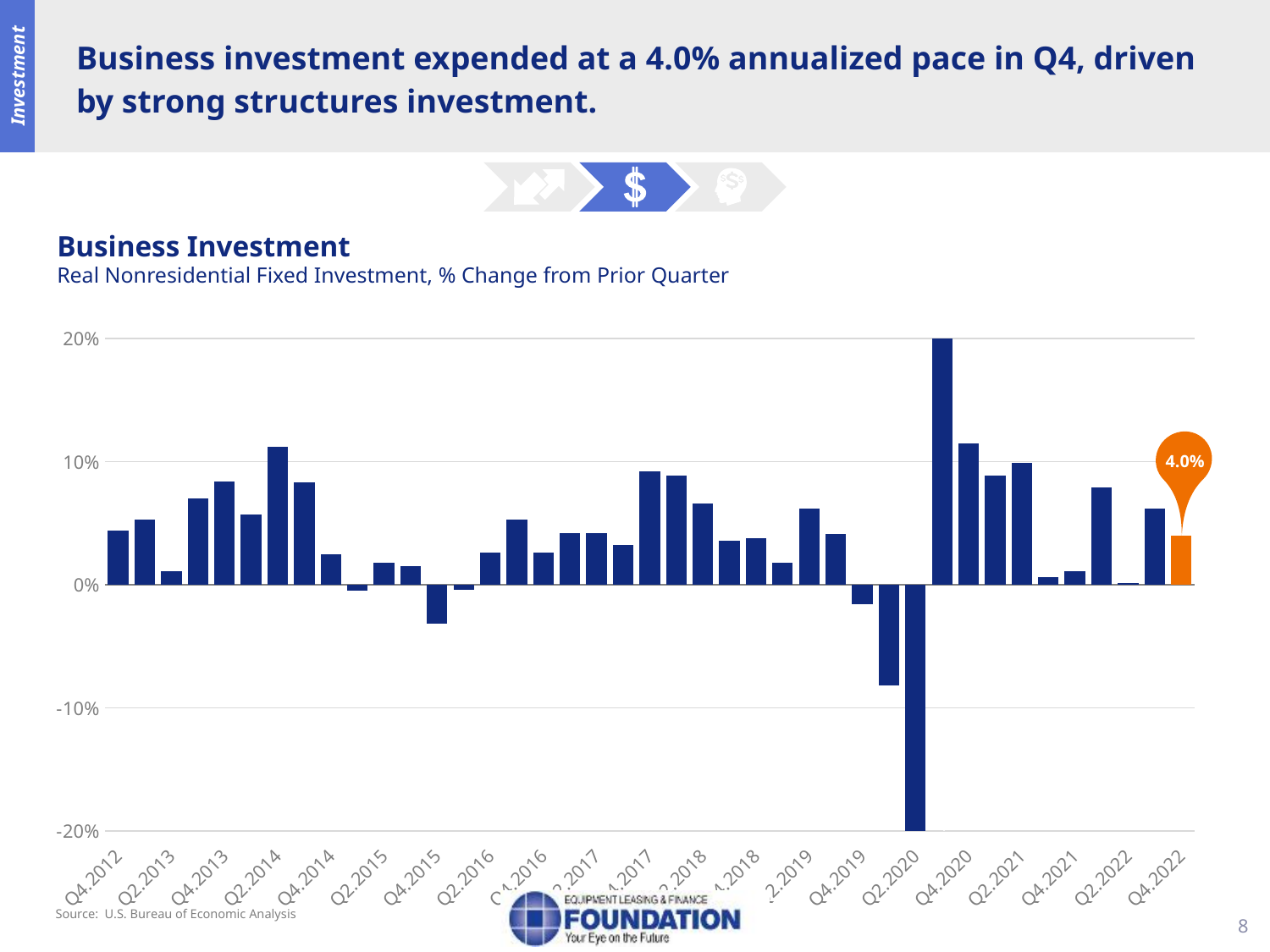
What is the value shown for Q4 2022? 4.0% Is the value for Q2 2020 greater or less than -10%? less Is the value for Q4 2012 greater or less than 10%? less What is the highest value shown on the y axis? 20% Which quarter has the lowest value in the chart? Q2 2020 Which is larger, the value for Q4 2022 or the value for Q2 2020? Q4 2022 What is the title of the chart? Business Investment What kind of chart is shown on the slide? bar chart Is the value for Q4 2022 greater or less than 10%? less What colour is the bar for Q4 2022? orange